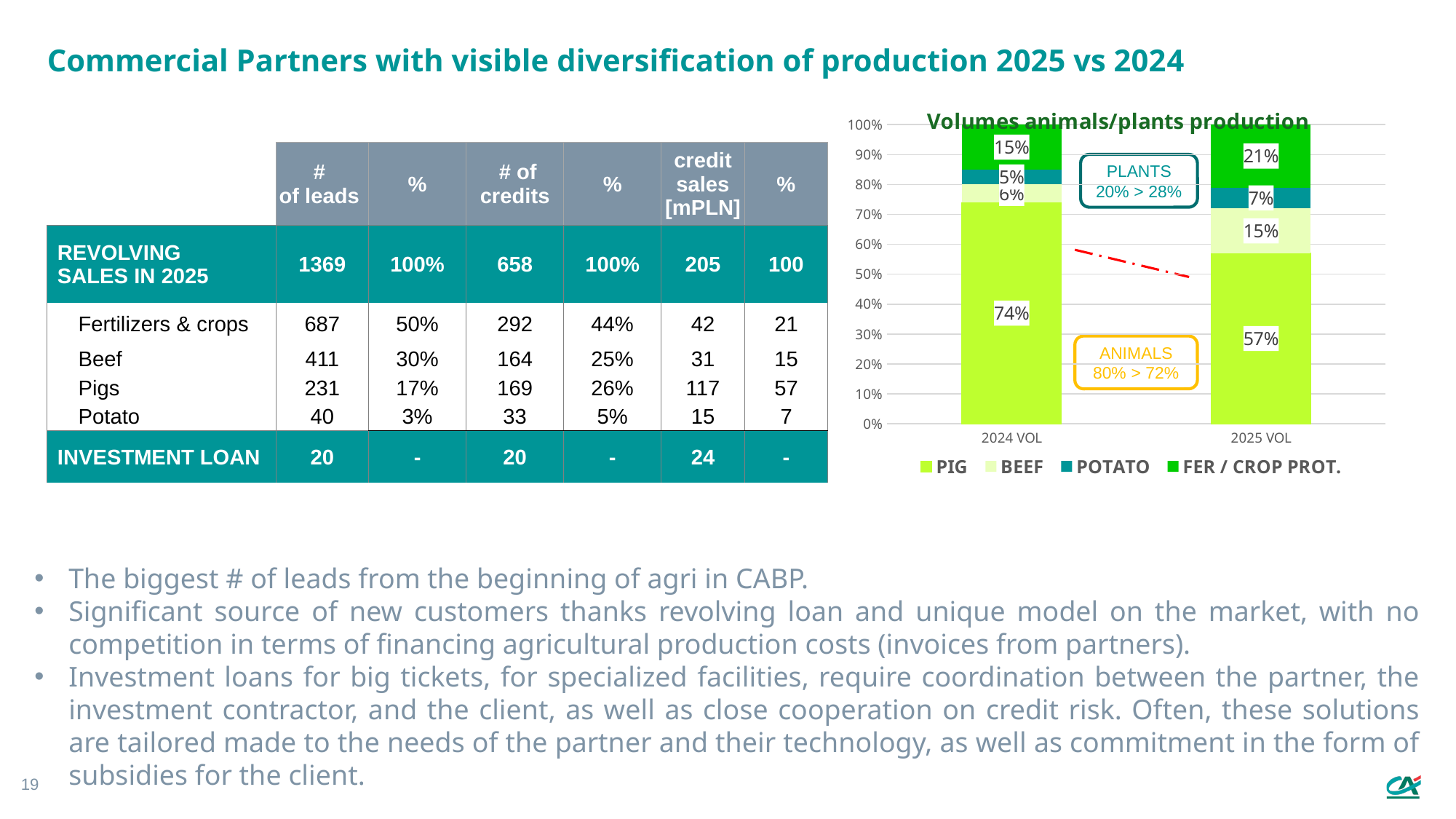
In the 'Volumes animals/plants production' chart, what is the BEEF share for 2025 VOL? 15% In the 'Volumes animals/plants production' chart, what is the PIG share for 2025 VOL? 57% How many bars are shown in the 'Volumes animals/plants production' chart? 2 In the 'Volumes animals/plants production' chart, what is the PIG share for 2024 VOL? 74% In the 'Volumes animals/plants production' chart, by how many percentage points did the PIG share fall from 2024 VOL to 2025 VOL? 17 In the 'Volumes animals/plants production' chart, is the FER / CROP PROT. share larger in 2024 VOL or 2025 VOL? 2025 VOL In the 'Volumes animals/plants production' chart, what is the POTATO share for 2024 VOL? 5% In the 'Volumes animals/plants production' chart, which series has the largest share in 2025 VOL? PIG In the 'Volumes animals/plants production' chart, what is the FER / CROP PROT. share for 2025 VOL? 21% In the 'Volumes animals/plants production' chart, which series has the smallest share in 2024 VOL? POTATO How many series does the legend of the 'Volumes animals/plants production' chart list? 4 What type of chart is 'Volumes animals/plants production'? stacked bar chart